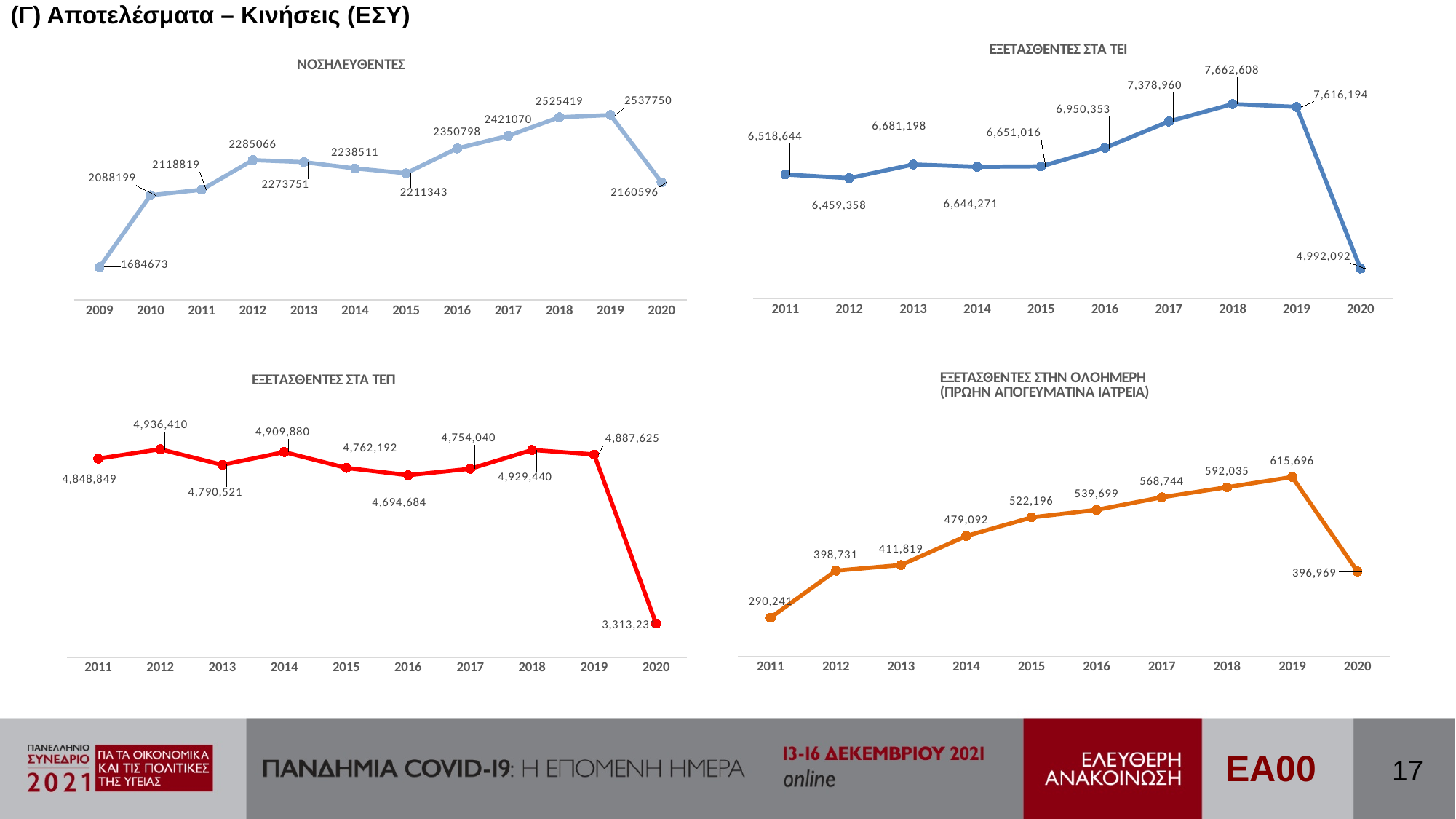
In the ΝΟΣΗΛΕΥΘΕΝΤΕΣ chart, what is the value for 2009? 1684673 In the ΕΞΕΤΑΣΘΕΝΤΕΣ ΣΤΑ ΤΕΙ chart, what is the difference between the 2018 and 2019 values? 46,414 In the ΝΟΣΗΛΕΥΘΕΝΤΕΣ chart, what is the difference between the 2019 and 2020 values? 377154 In the ΕΞΕΤΑΣΘΕΝΤΕΣ ΣΤΑ ΤΕΙ chart, what is the value for 2017? 7,378,960 In the ΕΞΕΤΑΣΘΕΝΤΕΣ ΣΤΑ ΤΕΠ chart, which is larger, the value for 2012 or the value for 2013? 2012 In the ΕΞΕΤΑΣΘΕΝΤΕΣ ΣΤΗΝ ΟΛΟΗΜΕΡΗ chart, what is the difference between the 2019 and 2020 values? 218,727 In the ΕΞΕΤΑΣΘΕΝΤΕΣ ΣΤΑ ΤΕΙ chart, which year has the lowest value? 2020 How many years are plotted in the ΝΟΣΗΛΕΥΘΕΝΤΕΣ chart? 12 What kind of chart is the ΕΞΕΤΑΣΘΕΝΤΕΣ ΣΤΑ ΤΕΠ chart? Line chart In the ΝΟΣΗΛΕΥΘΕΝΤΕΣ chart, which year has the highest value? 2019 In the ΕΞΕΤΑΣΘΕΝΤΕΣ ΣΤΗΝ ΟΛΟΗΜΕΡΗ chart, what is the value for 2015? 522,196 In the ΕΞΕΤΑΣΘΕΝΤΕΣ ΣΤΑ ΤΕΠ chart, what is the value for 2016? 4,694,684